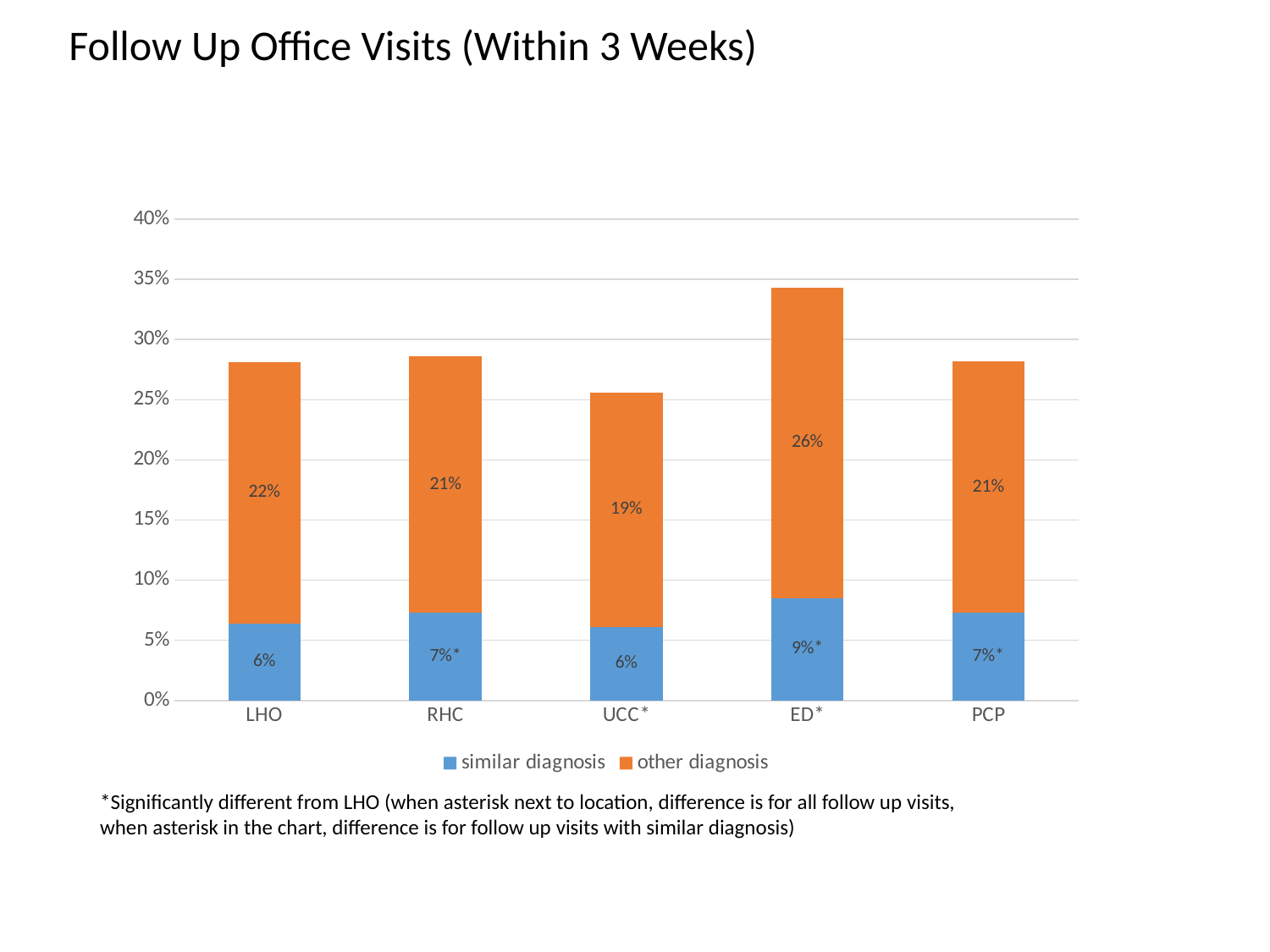
What is the value for other diagnosis at UCC*? 19% What is the value for similar diagnosis at PCP? 7% Which is larger, the similar diagnosis value for ED* or for LHO? ED* How many series does the legend list? 2 Is the total height of the ED* bar greater or less than 30%? greater Which location has the lowest value for other diagnosis? UCC* What is the value for other diagnosis at LHO? 22% Which location has the highest value for other diagnosis? ED* What is the value for similar diagnosis at ED*? 9% How many locations are shown on the x axis? 5 Which location has the highest value for similar diagnosis? ED* What is the difference between the other diagnosis values for ED* and UCC*? 7%